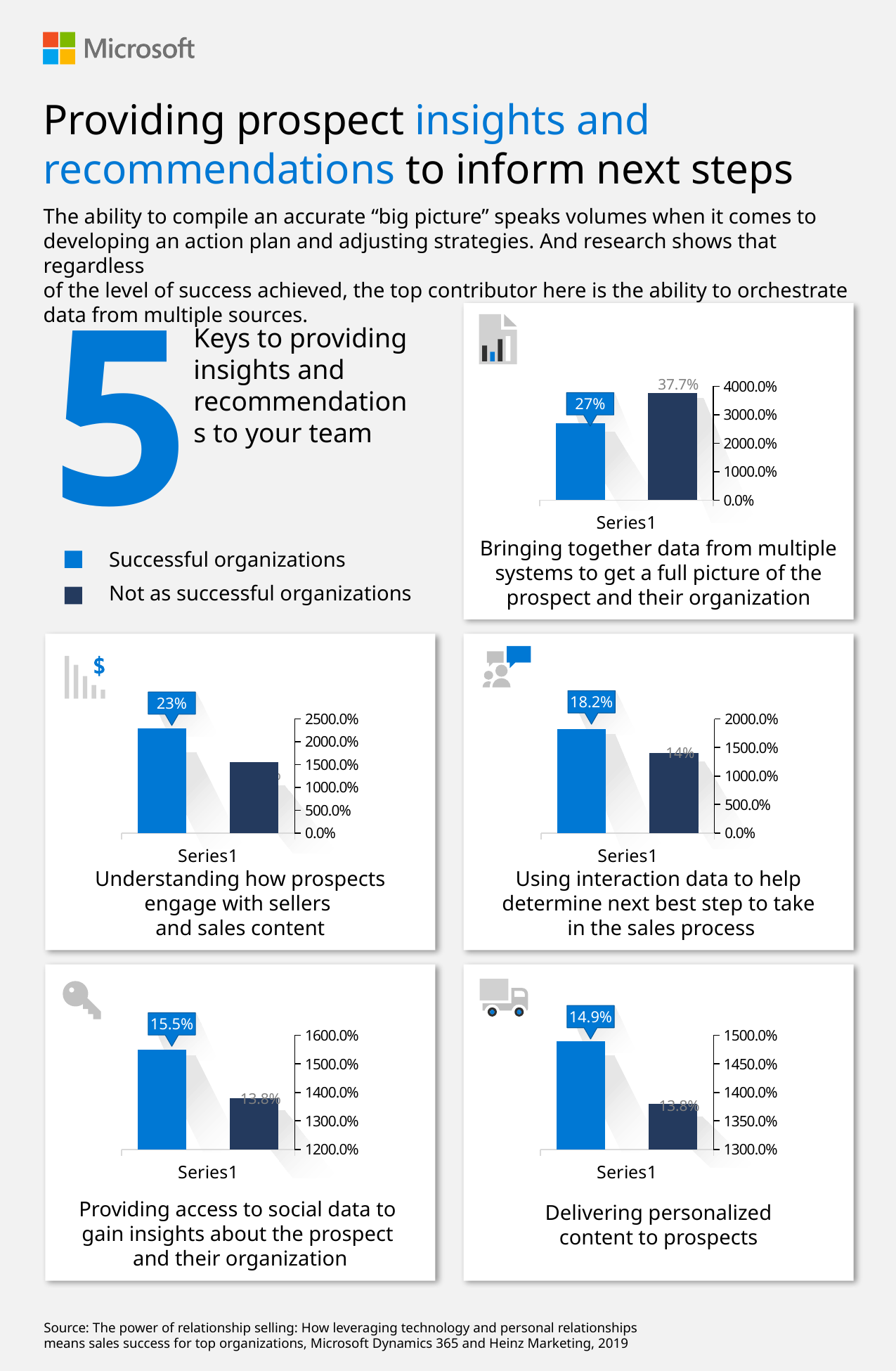
In the chart captioned "Using interaction data to help determine next best step to take in the sales process", what is the value for not as successful organizations? 14% In the chart captioned "Providing access to social data to gain insights about the prospect and their organization", what is the difference between the successful and not as successful organizations' values? 1.7% How many bars are shown in the chart captioned "Understanding how prospects engage with sellers and sales content"? 2 What kind of chart is used in the chart captioned "Delivering personalized content to prospects"? Bar chart In the chart captioned "Bringing together data from multiple systems to get a full picture of the prospect and their organization", what is the value for successful organizations? 27% In the chart captioned "Delivering personalized content to prospects", what is the value for not as successful organizations? 13.8% In the chart captioned "Bringing together data from multiple systems to get a full picture of the prospect and their organization", what is the value for not as successful organizations? 37.7% In the chart captioned "Delivering personalized content to prospects", which group has the higher value? Successful organizations In the chart captioned "Providing access to social data to gain insights about the prospect and their organization", what is the value for successful organizations? 15.5% In the chart captioned "Bringing together data from multiple systems to get a full picture of the prospect and their organization", which group has the higher value? Not as successful organizations In the chart captioned "Using interaction data to help determine next best step to take in the sales process", what is the value for successful organizations? 18.2% In the chart captioned "Understanding how prospects engage with sellers and sales content", what is the value for successful organizations? 23%